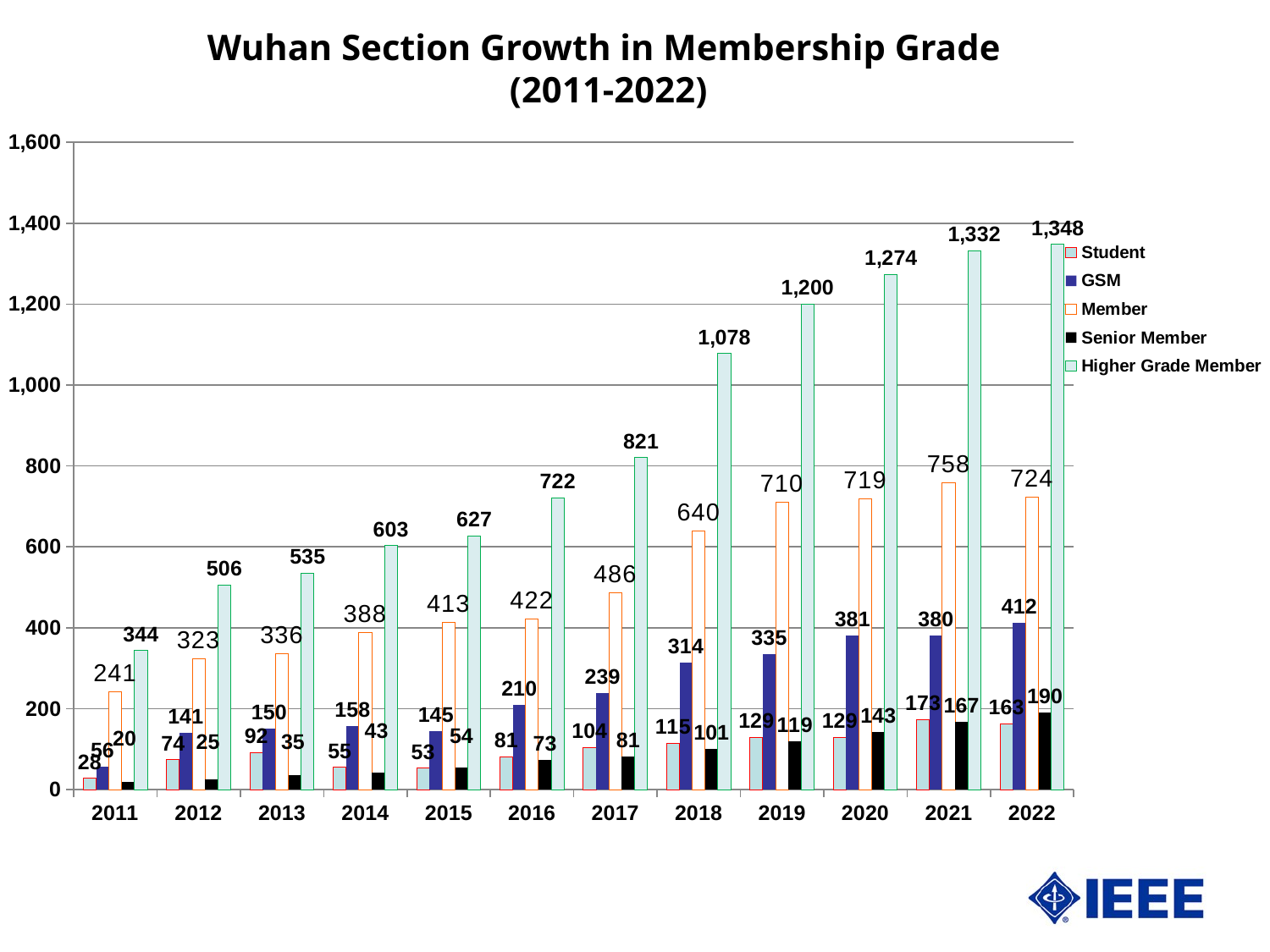
In which year is the Student value lowest? 2011 What is the value for Member in 2021? 758 Which is larger, the Member value in 2020 or in 2022? 2022 Does the Higher Grade Member value rise or fall from 2011 to 2022? Rise How many series does the legend list? 5 How many years are shown on the x axis? 12 What kind of chart is shown on the slide? Bar chart In which year is the GSM value highest? 2022 What is the value for Higher Grade Member in 2022? 1,348 What colour are the Senior Member bars? Black What is the value for Senior Member in 2011? 20 By how much did the Higher Grade Member value increase from 2011 to 2022? 1,004